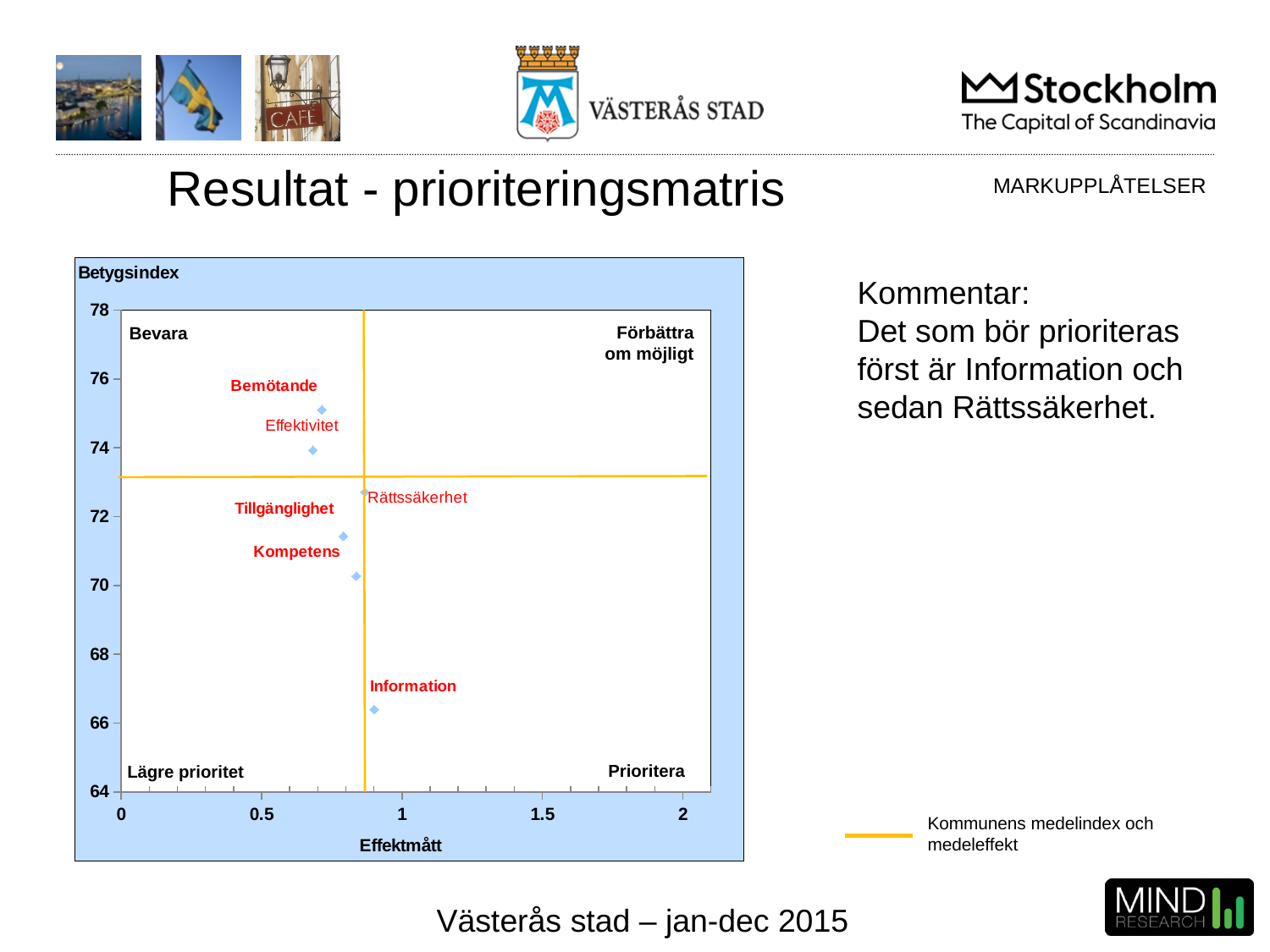
Is the Betygsindex for Bemötande greater or less than 74? greater Which has a higher Betygsindex, Effektivitet or Tillgänglighet? Effektivitet Which has a higher Betygsindex, Tillgänglighet or Kompetens? Tillgänglighet What is the label of the horizontal axis of the chart? Effektmått Is the Betygsindex for Kompetens greater or less than 72? less What label is shown in the top-right quadrant of the chart? Förbättra om möjligt Which point has the lowest Betygsindex? Information Which point has the highest Betygsindex? Bemötande How many data points are plotted in the chart? 6 Is the Betygsindex for Information greater or less than 68? less What kind of chart is shown on the slide? scatter plot